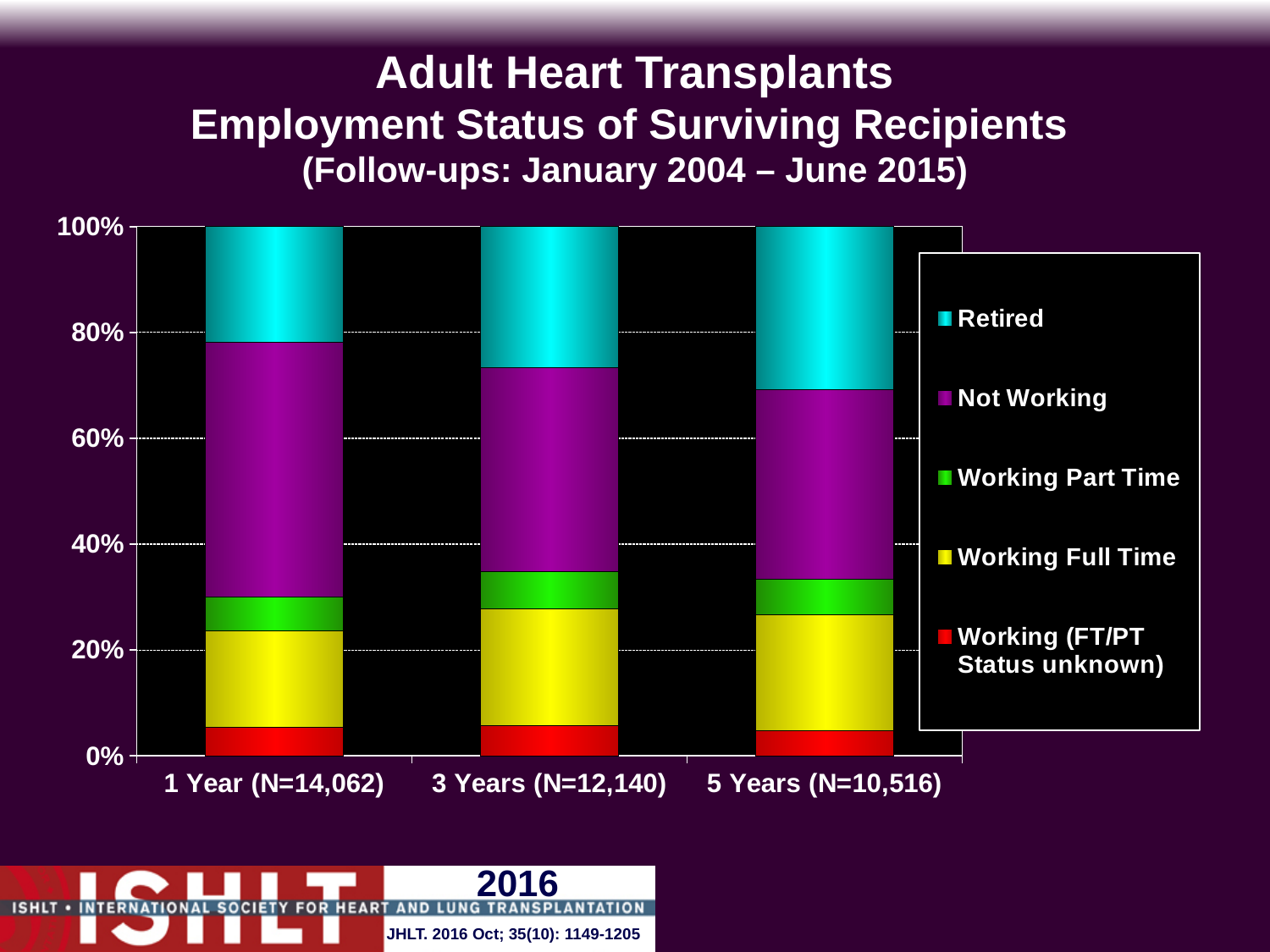
Does the Retired segment grow or shrink from 1 Year to 5 Years? Grows What kind of chart is shown on the slide? Stacked bar chart Is the top of the Working Full Time segment for 3 Years above or below 40%? Below Is the Not Working segment larger at 1 Year or at 5 Years? 1 Year What is the total height of each stacked bar? 100% How many follow-up time points (categories) are shown on the x axis? 3 Which follow-up time point has the smallest Retired segment? 1 Year (N=14,062) Which follow-up time point has the largest Retired segment? 5 Years (N=10,516) Which colour represents Retired in the legend? Cyan (light blue) What is the N for the 1 Year follow-up category? 14,062 Is the top of the Not Working segment for 1 Year above or below 60%? Above How many series does the legend list? 5